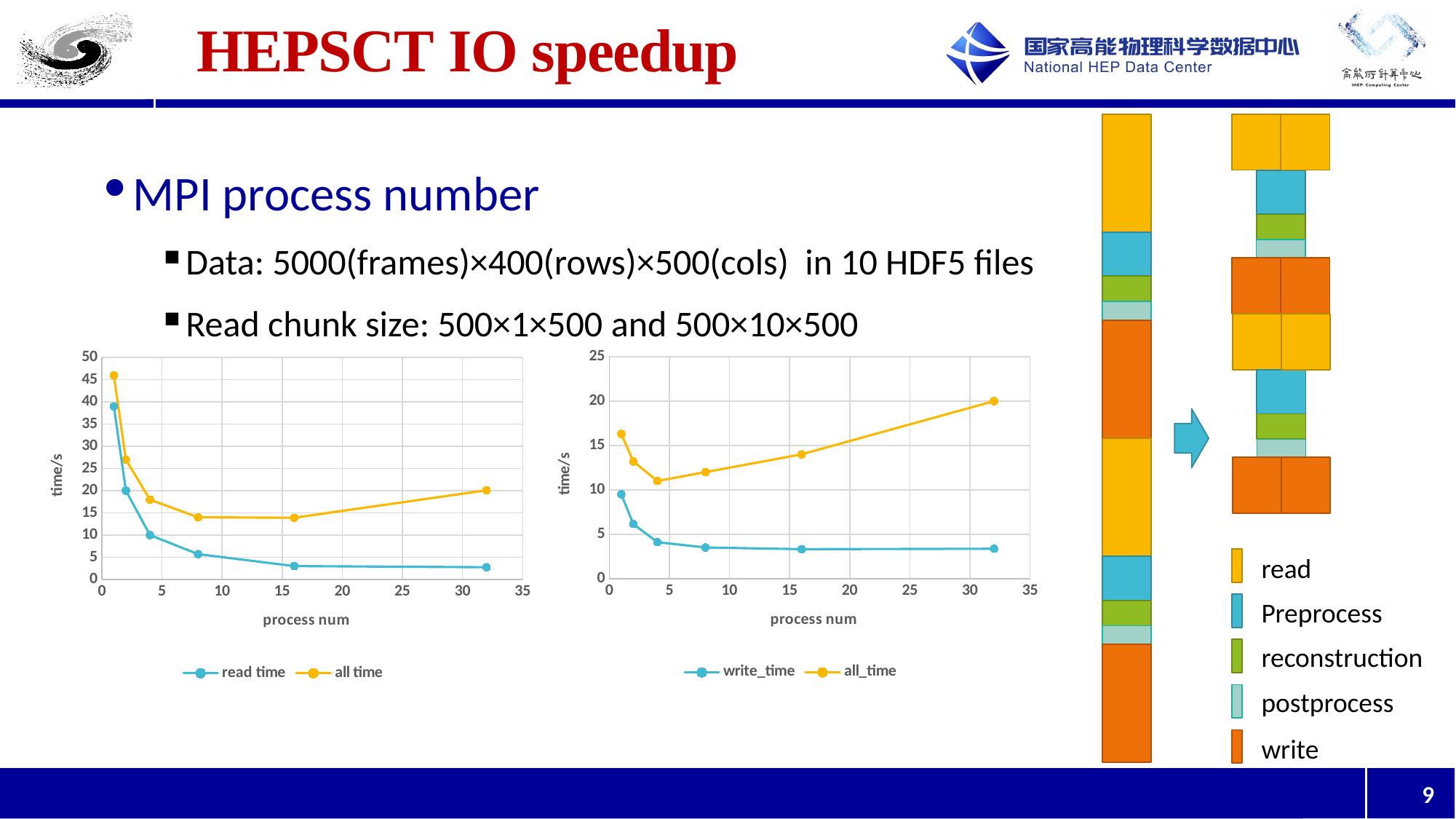
In the left chart, does the read time rise or fall as process num increases? fall In the right chart, which is larger: the all_time value at process num 32 or at process num 1? process num 32 What are the two legend entries of the right chart? write_time, all_time How many series does the legend of the left chart list? 2 In the left chart, is the read time value at process num 32 greater or less than 5? less In the right chart, is the all_time value at process num 32 greater or less than 15? greater What kind of chart is the left chart (read time / all time)? line chart How many data points does the read time series in the left chart have? 6 In the left chart, at which process num is the all time highest? 1 In the right chart, is the write_time value at process num 1 greater or less than 5? greater What are the two legend entries of the left chart? read time, all time